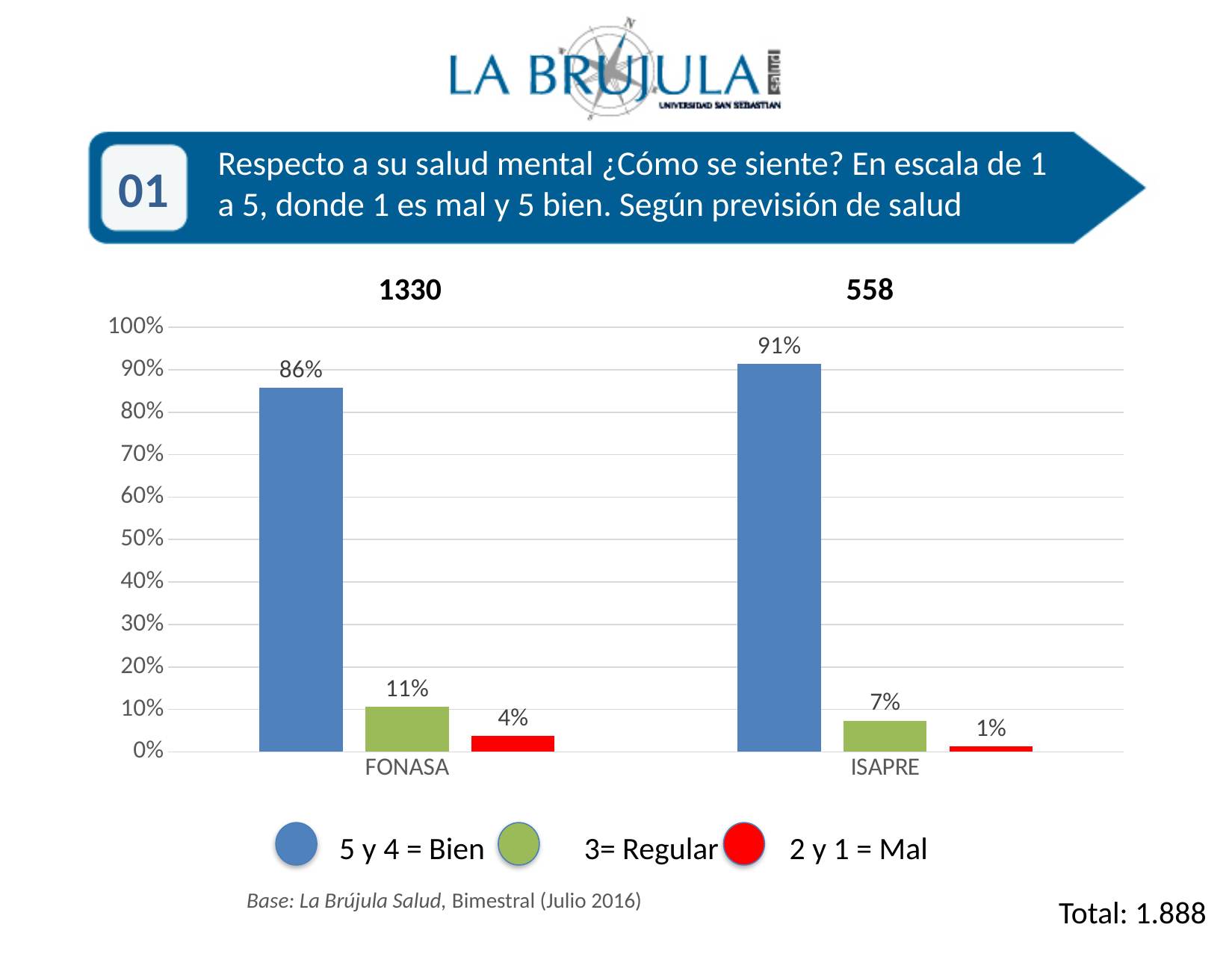
What percentage of FONASA respondents rated their mental health as Bien (5 y 4)? 86% Which category has the lowest value on the chart? ISAPRE Mal (2 y 1), 1% How many health insurance groups are shown on the x axis? 2 Which health insurance group has the higher share of Bien (5 y 4) responses? ISAPRE What kind of chart is shown on the slide? Bar chart What is the difference between the Bien (5 y 4) percentages for ISAPRE and FONASA? 5% What number is shown above the FONASA group of bars? 1330 How many series does the legend list? 3 What is the difference between the Regular (3) percentages for FONASA and ISAPRE? 4% What percentage of FONASA respondents rated their mental health as Mal (2 y 1)? 4% What percentage of ISAPRE respondents rated their mental health as Bien (5 y 4)? 91% What percentage of ISAPRE respondents rated their mental health as Regular (3)? 7%